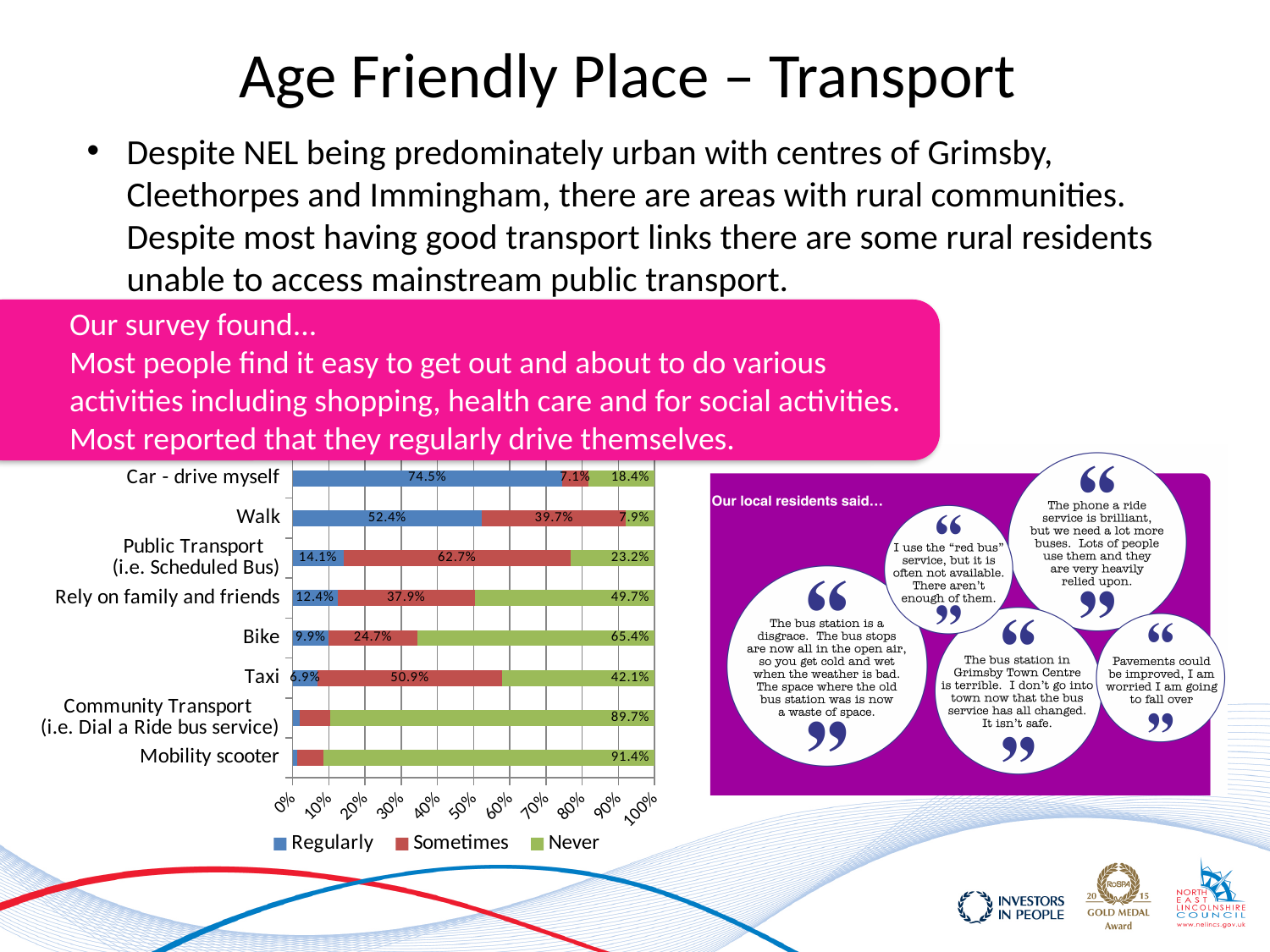
What type of chart is used to show the transport survey results? Stacked bar chart What is the difference between the 'Regularly' values for Car - drive myself and Walk? 22.1% How many series does the chart legend list? 3 What is the 'Never' value for Community Transport (i.e. Dial a Ride bus service)? 89.7% What is the 'Sometimes' value for Public Transport (i.e. Scheduled Bus)? 62.7% How many transport categories are shown in the chart? 8 Is the 'Regularly' value for Mobility scooter greater or less than 10%? less Which category has the lowest 'Never' value? Walk What percentage of respondents said they never use a mobility scooter? 91.4% Which category has the highest 'Regularly' value? Car - drive myself What percentage of respondents said they regularly drive themselves by car? 74.5% Which has a larger 'Sometimes' value, Taxi or Bike? Taxi